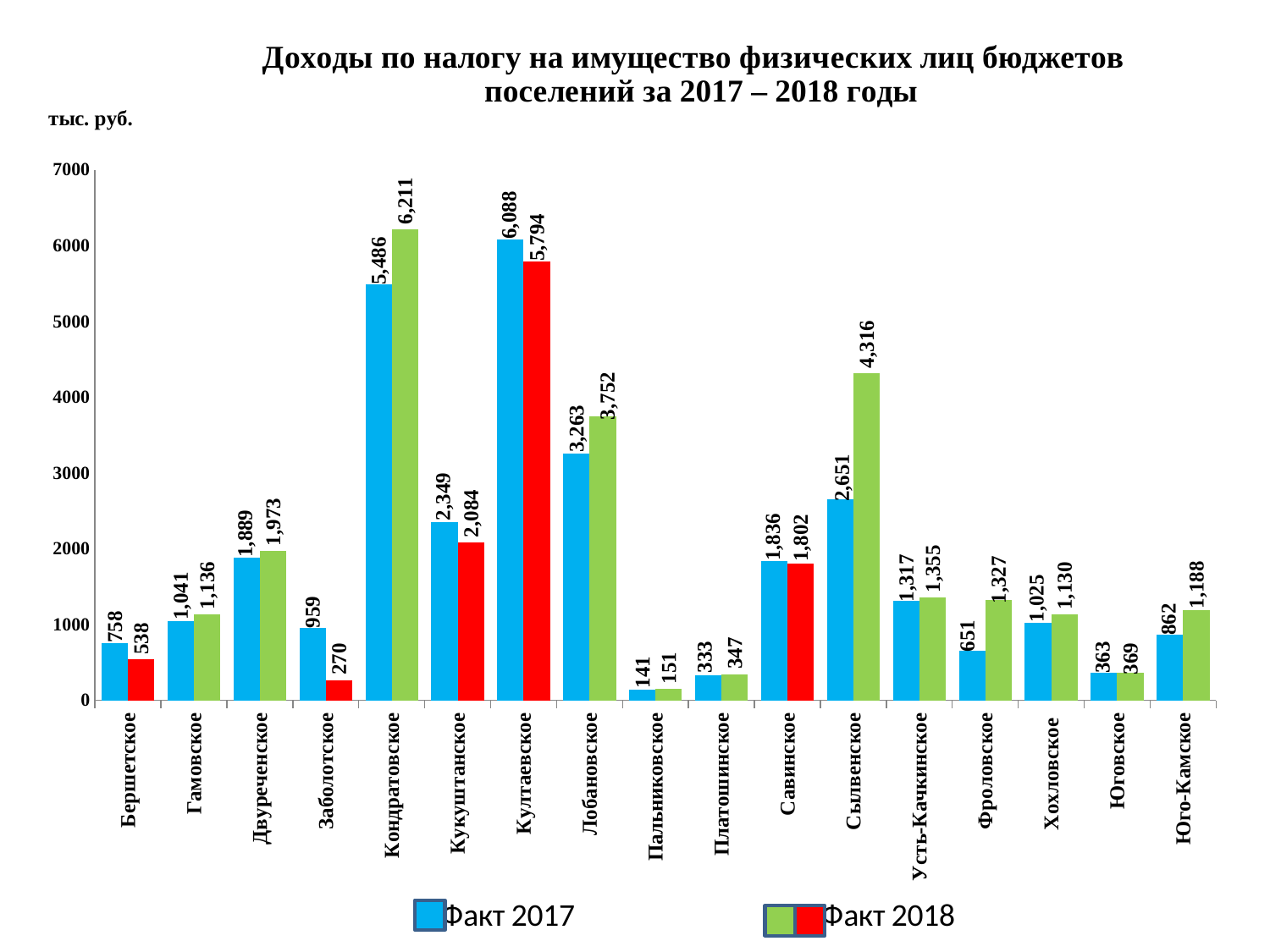
What is the Факт 2018 value for Сылвенское? 4,316 Which settlement has the lowest Факт 2017 value? Пальниковское Is the Факт 2018 value for Лобановское greater or less than 3000? greater What is the Факт 2017 value for Кондратовское? 5,486 How many series does the legend list? 2 Which is larger for Култаевское: the Факт 2017 value or the Факт 2018 value? Факт 2017 What is the Факт 2018 value for Заболотское? 270 What is the difference between the Факт 2018 and Факт 2017 values for Сылвенское? 1,665 Which settlement has the highest Факт 2018 value? Кондратовское Which settlement has the highest Факт 2017 value? Култаевское What kind of chart is shown on the slide? Bar chart How many settlements are shown on the x axis? 17